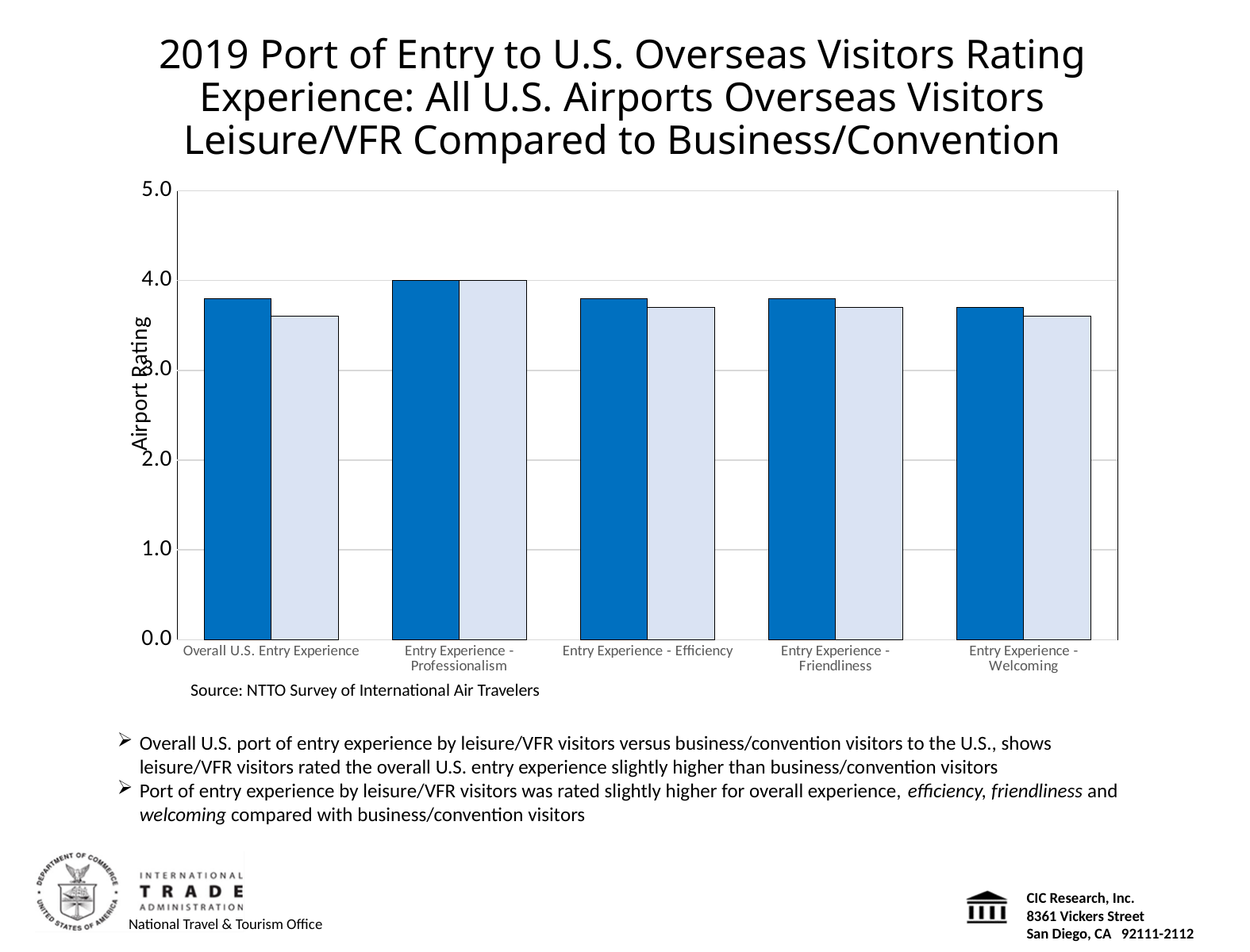
Is the dark blue bar for Overall U.S. Entry Experience greater or less than 3.0? greater What is the title of the y axis of the chart? Airport Rating Which category has the highest bars in the chart? Entry Experience - Professionalism What is the highest value shown on the y axis of the chart? 5.0 Is the light blue bar for Entry Experience - Friendliness greater or less than 2.0? greater How many bars are plotted for each category in the chart? 2 For Overall U.S. Entry Experience, which bar is taller, the dark blue bar or the light blue bar? dark blue bar How many categories are shown along the x axis of the chart? 5 What kind of chart is shown on the slide? bar chart Is the light blue bar for Entry Experience - Welcoming greater or less than 4.0? less Which dark blue bar is taller, Entry Experience - Professionalism or Entry Experience - Welcoming? Entry Experience - Professionalism